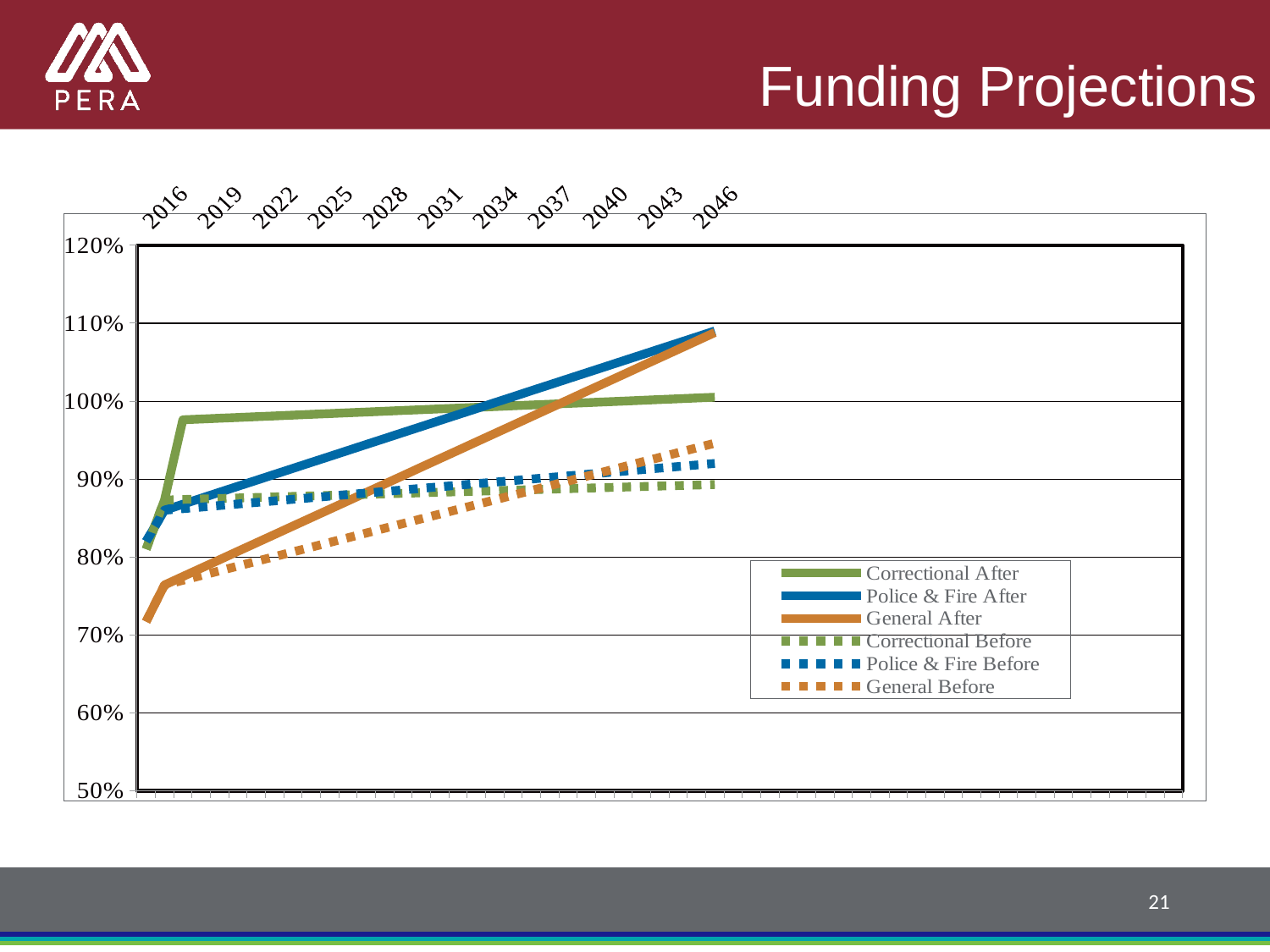
Does the General After series rise or fall from 2016 to 2046? Rise Is the value for General After in 2016 greater or less than 80%? less Is the value for General Before in 2046 greater or less than 90%? greater How many series does the legend list? 6 What is the title of the slide containing the chart? Funding Projections What kind of chart is shown on the slide? Line chart In 2046, which is higher: Police & Fire After or Correctional After? Police & Fire After In 2046, which is higher: General After or General Before? General After How many year labels are shown along the x axis? 11 Which legend entries are drawn with dashed lines? Correctional Before, Police & Fire Before, General Before Which series has the lowest value in 2016? General After and General Before (tied) Is the value for Police & Fire After in 2046 greater or less than 100%? greater